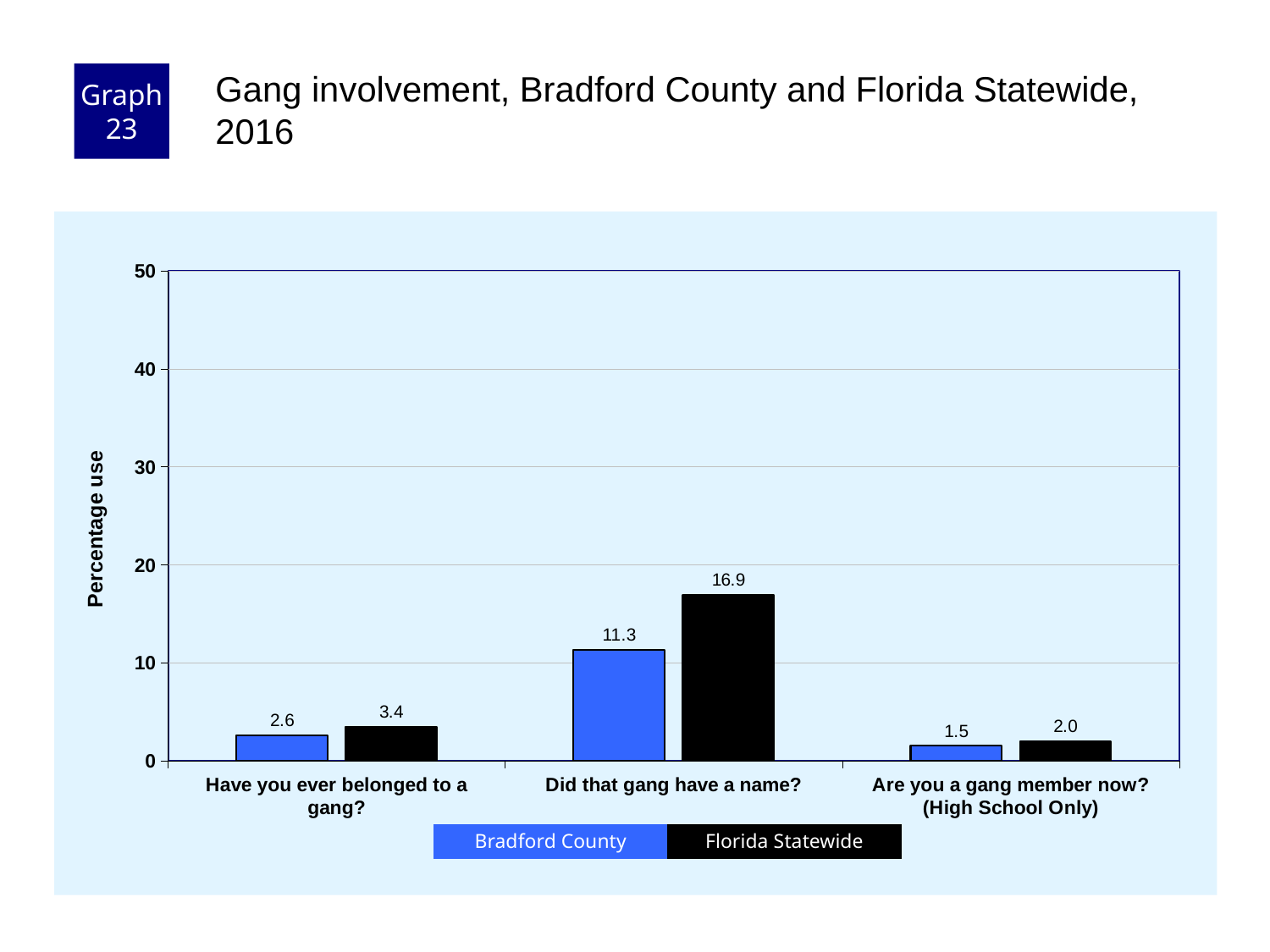
How many question categories are shown on the x axis? 3 Which question has the highest Florida Statewide value? Did that gang have a name? How many series does the legend list? 2 What is the Bradford County value for "Have you ever belonged to a gang?"? 2.6 What is the Bradford County value for "Are you a gang member now? (High School Only)"? 1.5 Is the Bradford County value for "Did that gang have a name?" greater or less than 10? greater Which question has the lowest Bradford County value? Are you a gang member now? (High School Only) What kind of chart is shown on the slide? Bar chart For "Are you a gang member now? (High School Only)", which series has the larger value, Bradford County or Florida Statewide? Florida Statewide What is the difference between the Florida Statewide and Bradford County values for "Did that gang have a name?"? 5.6 What is the Florida Statewide value for "Did that gang have a name?"? 16.9 What is the Florida Statewide value for "Have you ever belonged to a gang?"? 3.4